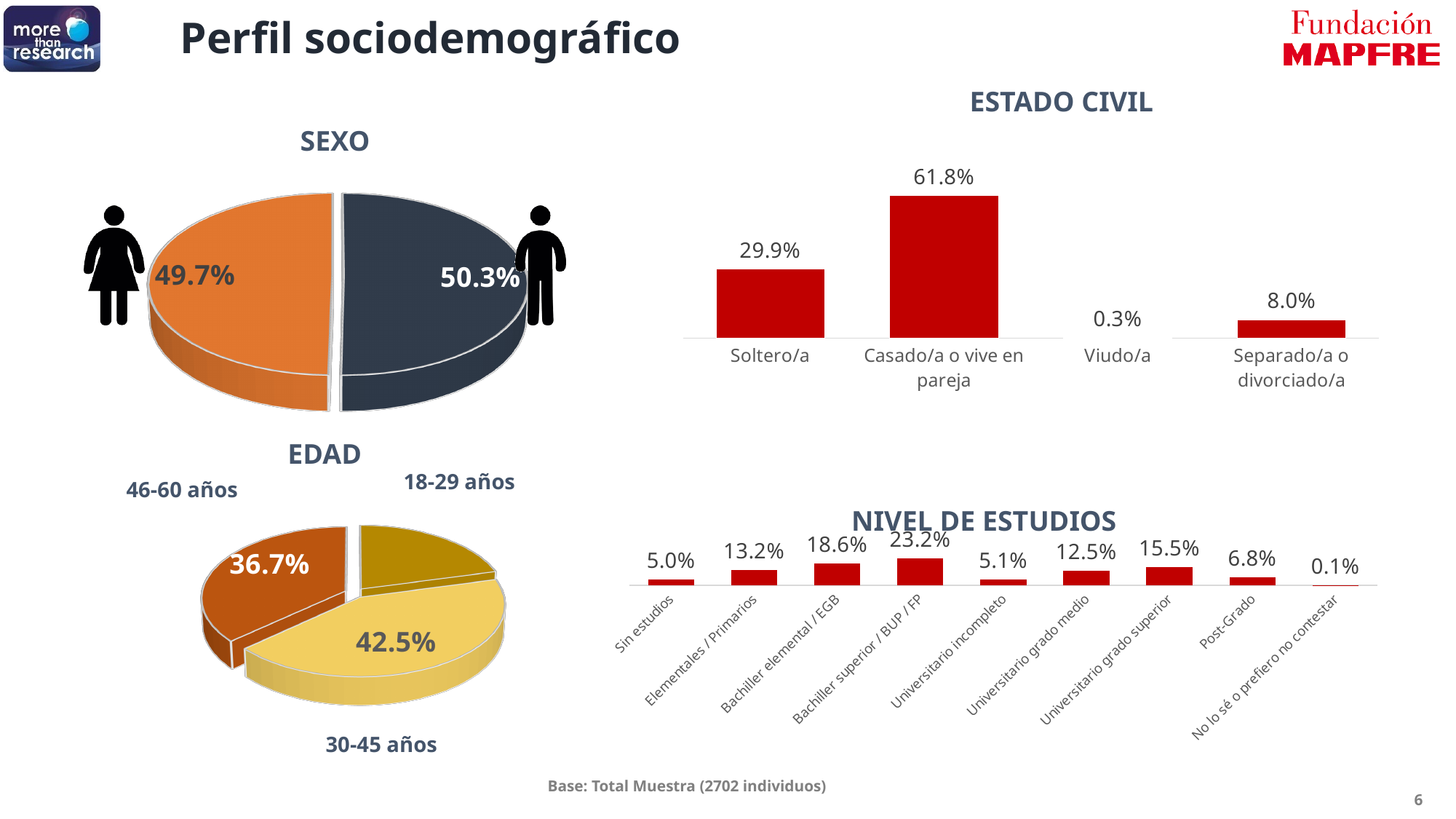
In the NIVEL DE ESTUDIOS chart, which category has the highest value? Bachiller superior / BUP / FP In the EDAD chart, what is the value for 30-45 años? 42.5% In the NIVEL DE ESTUDIOS chart, what is the value for Universitario grado superior? 15.5% In the SEXO chart, what share of the pie is the male (dark) slice? 50.3% In the NIVEL DE ESTUDIOS chart, what is the value for No lo sé o prefiero no contestar? 0.1% In the NIVEL DE ESTUDIOS chart, how many categories are shown? 9 In the NIVEL DE ESTUDIOS chart, which is larger: Elementales / Primarios or Universitario grado medio? Elementales / Primarios In the ESTADO CIVIL chart, what is the value for Casado/a o vive en pareja? 61.8% In the ESTADO CIVIL chart, which category has the lowest value? Viudo/a In the ESTADO CIVIL chart, what is the difference between Soltero/a and Separado/a o divorciado/a? 21.9% What kind of chart is the ESTADO CIVIL chart? Bar chart In the ESTADO CIVIL chart, how many categories are shown? 4